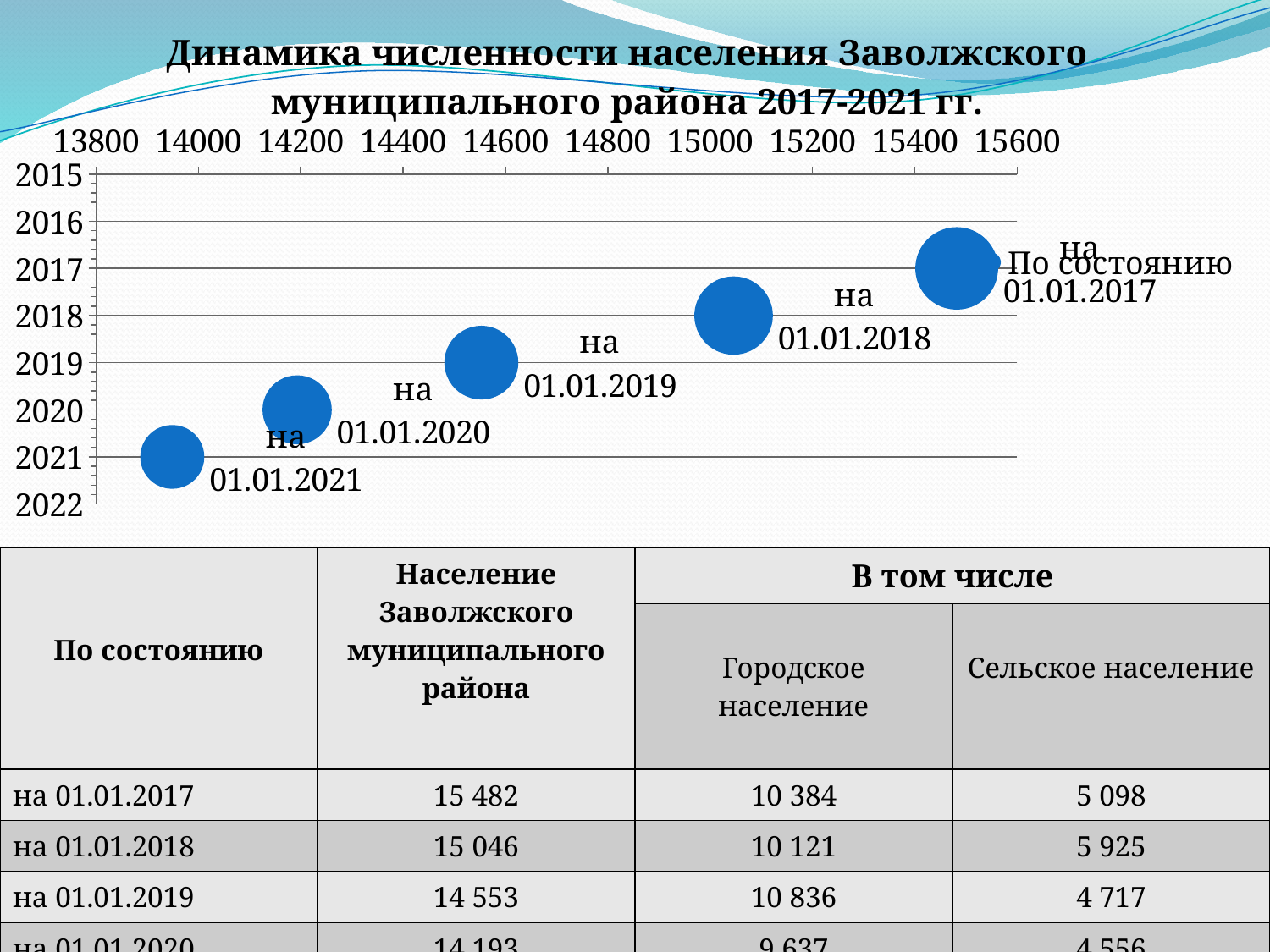
Is the value for на 01.01.2017 greater or less than 15400? greater Is the value for на 01.01.2018 greater or less than 14800? greater Is the value for на 01.01.2019 greater or less than 14400? greater Which is larger, the value for на 01.01.2018 or the value for на 01.01.2020? на 01.01.2018 Which date has the highest population value on the chart? на 01.01.2017 How many data points (bubbles) are plotted on the chart? 5 According to the table on the slide, what is the population of the district на 01.01.2017? 15 482 What kind of chart is shown on the slide? bubble chart Which date has the lowest population value on the chart? на 01.01.2021 What is the title of the chart? Динамика численности населения Заволжского муниципального района 2017-2021 гг. Does the population rise or fall from 01.01.2017 to 01.01.2021? fall